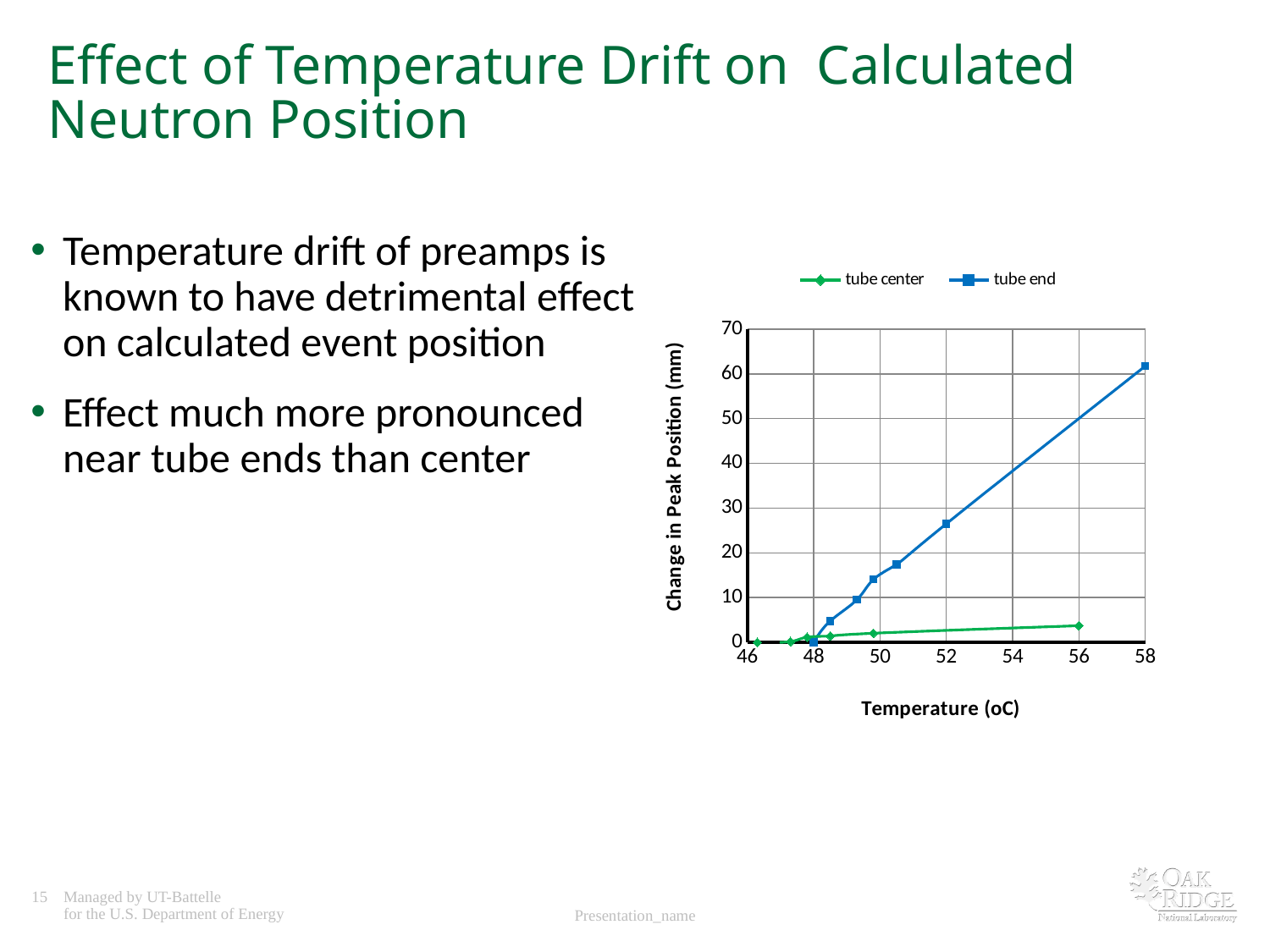
Does the tube end series rise or fall as temperature increases? rise Is the value for tube center at 56 °C greater or less than 10? less Is the value for tube end at 58 °C greater or less than 60? greater What is the label of the chart's y axis? Change in Peak Position (mm) Is the value for tube end at 52 °C greater or less than 20? greater How many series does the chart legend list? 2 What kind of chart is shown on the slide? line chart Which series has the lowest values across the temperature range, tube center or tube end? tube center Which series reaches the higher change in peak position at the right end of the chart, tube center or tube end? tube end What are the two series named in the chart legend? tube center and tube end